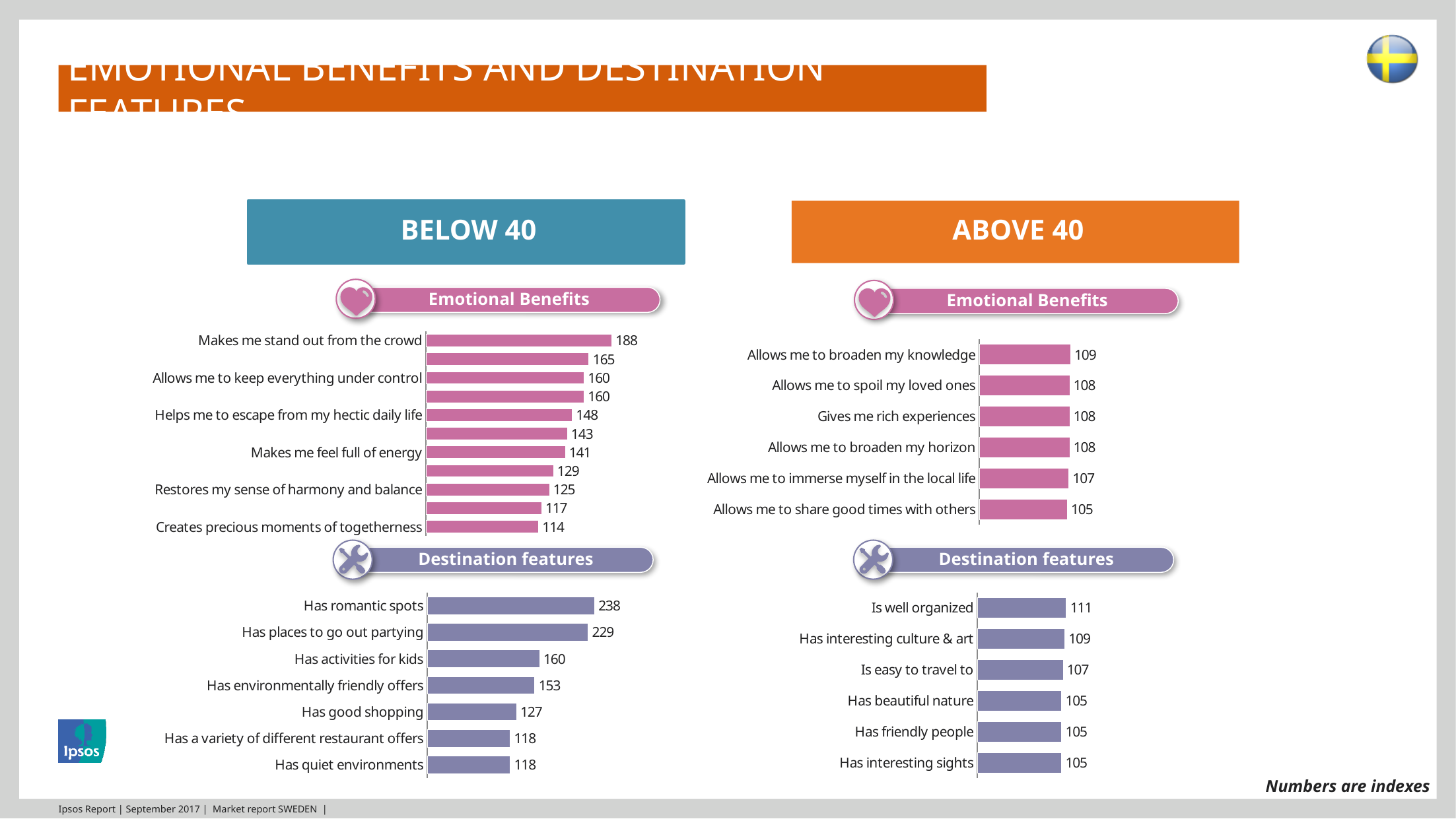
What are the two age groups compared on the slide? Below 40 and Above 40 In the Below 40 Destination features chart, what is the difference between 'Has romantic spots' and 'Has places to go out partying'? 9 What type of chart is the Above 40 Destination features chart? Bar chart How many categories are shown in the Above 40 Emotional Benefits chart? 6 In the Above 40 Emotional Benefits chart, what is the value for 'Allows me to immerse myself in the local life'? 107 In the Below 40 Emotional Benefits chart, what is the value for 'Makes me stand out from the crowd'? 188 In the Above 40 Emotional Benefits chart, which category has the lowest value? Allows me to share good times with others In the Above 40 Destination features chart, what is the difference between 'Is well organized' and 'Has interesting sights'? 6 In the Above 40 Destination features chart, which category has the highest value? Is well organized How many categories are shown in the Below 40 Destination features chart? 7 In the Below 40 Destination features chart, what is the value for 'Has romantic spots'? 238 In the Below 40 Emotional Benefits chart, which is larger: 'Helps me to escape from my hectic daily life' or 'Restores my sense of harmony and balance'? Helps me to escape from my hectic daily life